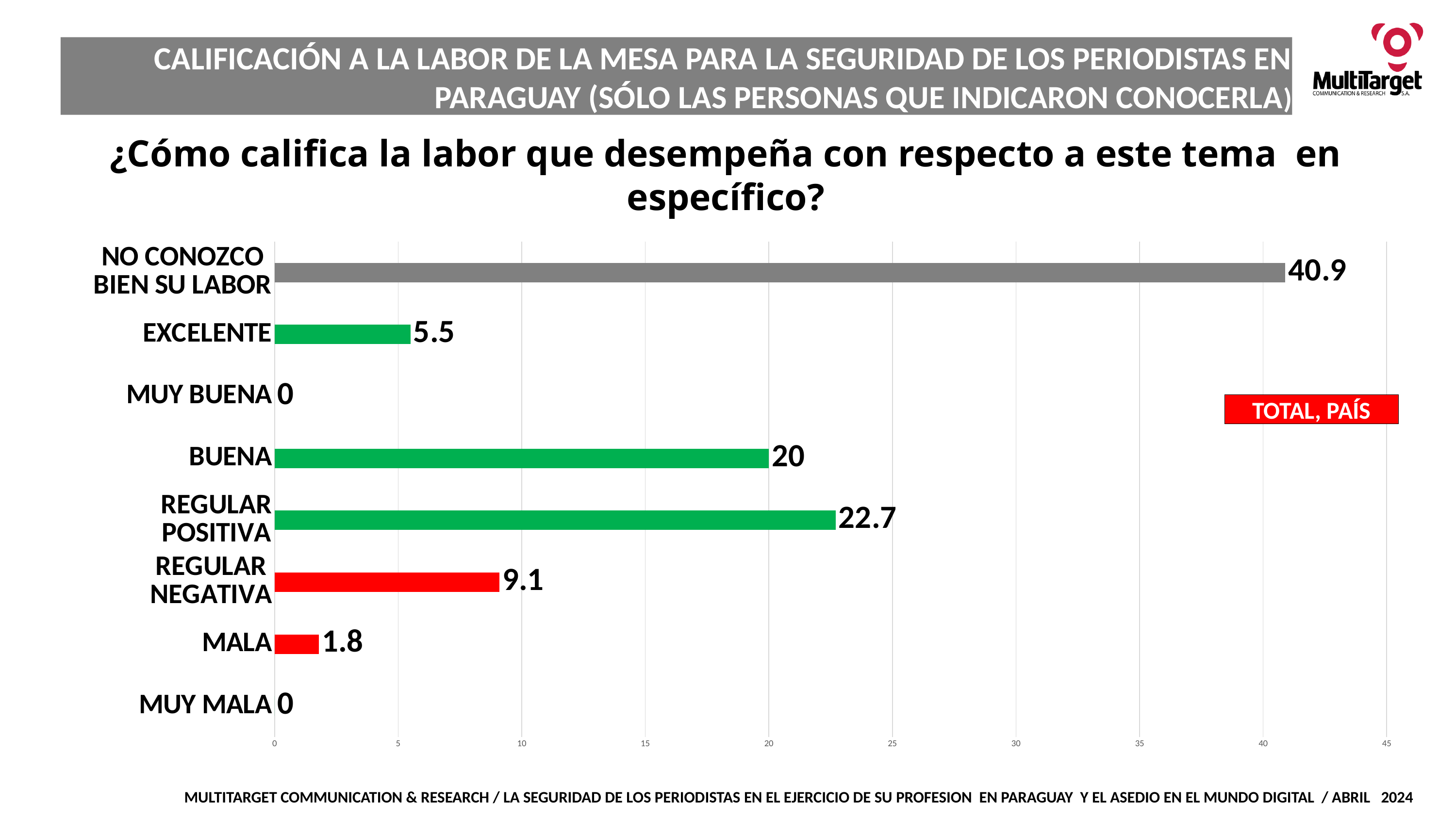
What is the value for REGULAR NEGATIVA? 9.1 What kind of chart is shown on the slide? Bar chart What is the value for NO CONOZCO BIEN SU LABOR? 40.9 What is the value for EXCELENTE? 5.5 What is the value for REGULAR POSITIVA? 22.7 What is the difference between the values for REGULAR NEGATIVA and MALA? 7.3 Which category has the lowest non-zero value? MALA How many categories are shown on the chart? 8 Which category has the highest value? NO CONOZCO BIEN SU LABOR Which is larger, the value for BUENA or the value for REGULAR NEGATIVA? BUENA What is the legend entry shown on the chart? TOTAL, PAÍS What is the difference between the values for REGULAR POSITIVA and BUENA? 2.7